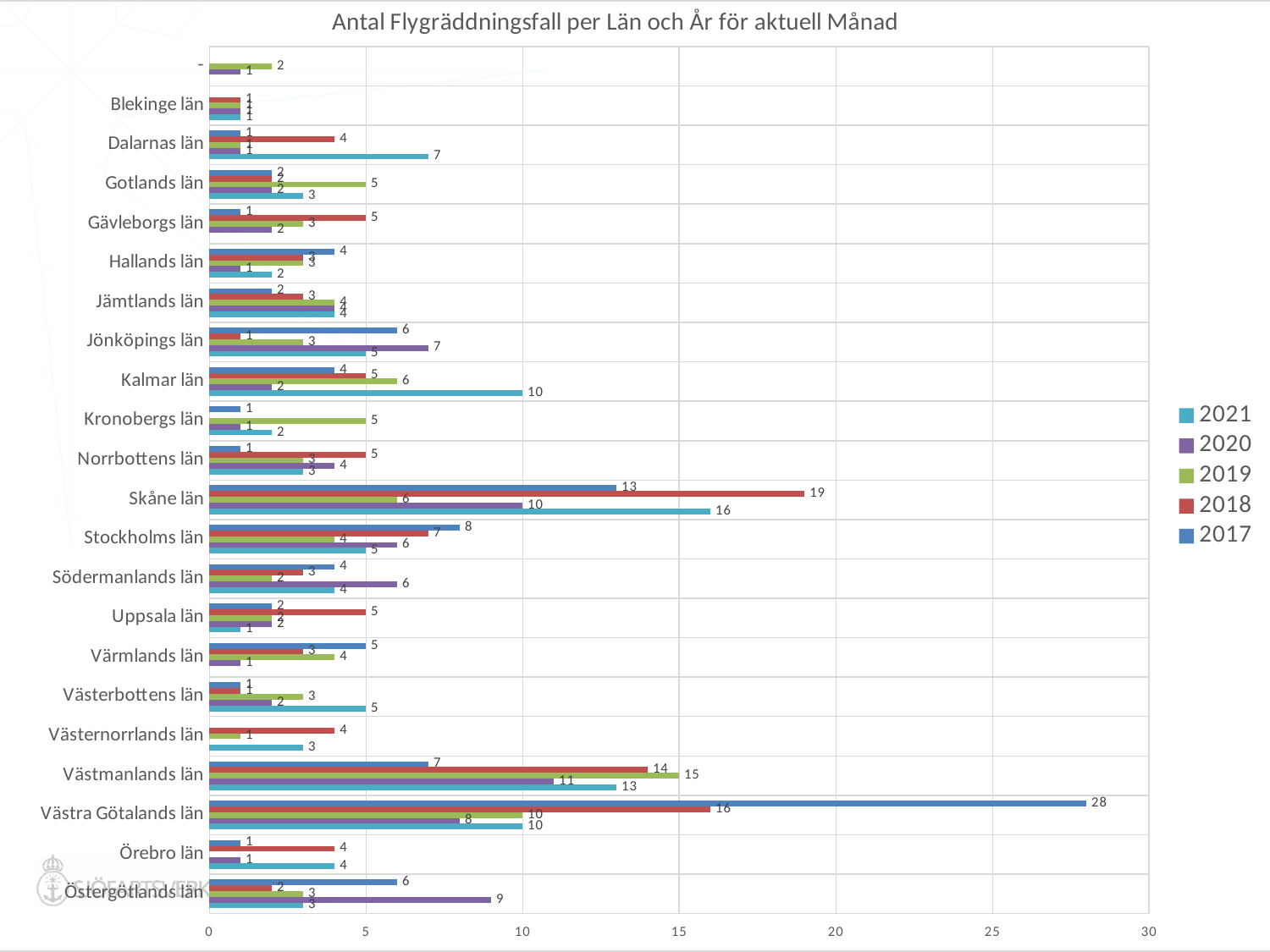
Is the value for Västra Götalands län in 2017 greater or less than 25? greater What is the title of the chart? Antal Flygräddningsfall per Län och År för aktuell Månad What is the value for Västra Götalands län in 2017? 28 What is the value for Dalarnas län in 2021? 7 Which county has the highest value for 2017? Västra Götalands län For Västmanlands län, which year has the larger value, 2018 or 2019? 2019 What is the value for Kalmar län in 2021? 10 What kind of chart is shown on the slide? bar chart Which county has the highest value for 2021? Skåne län What is the difference between the 2018 and 2021 values for Skåne län? 3 What is the value for Skåne län in 2018? 19 How many series does the legend list? 5